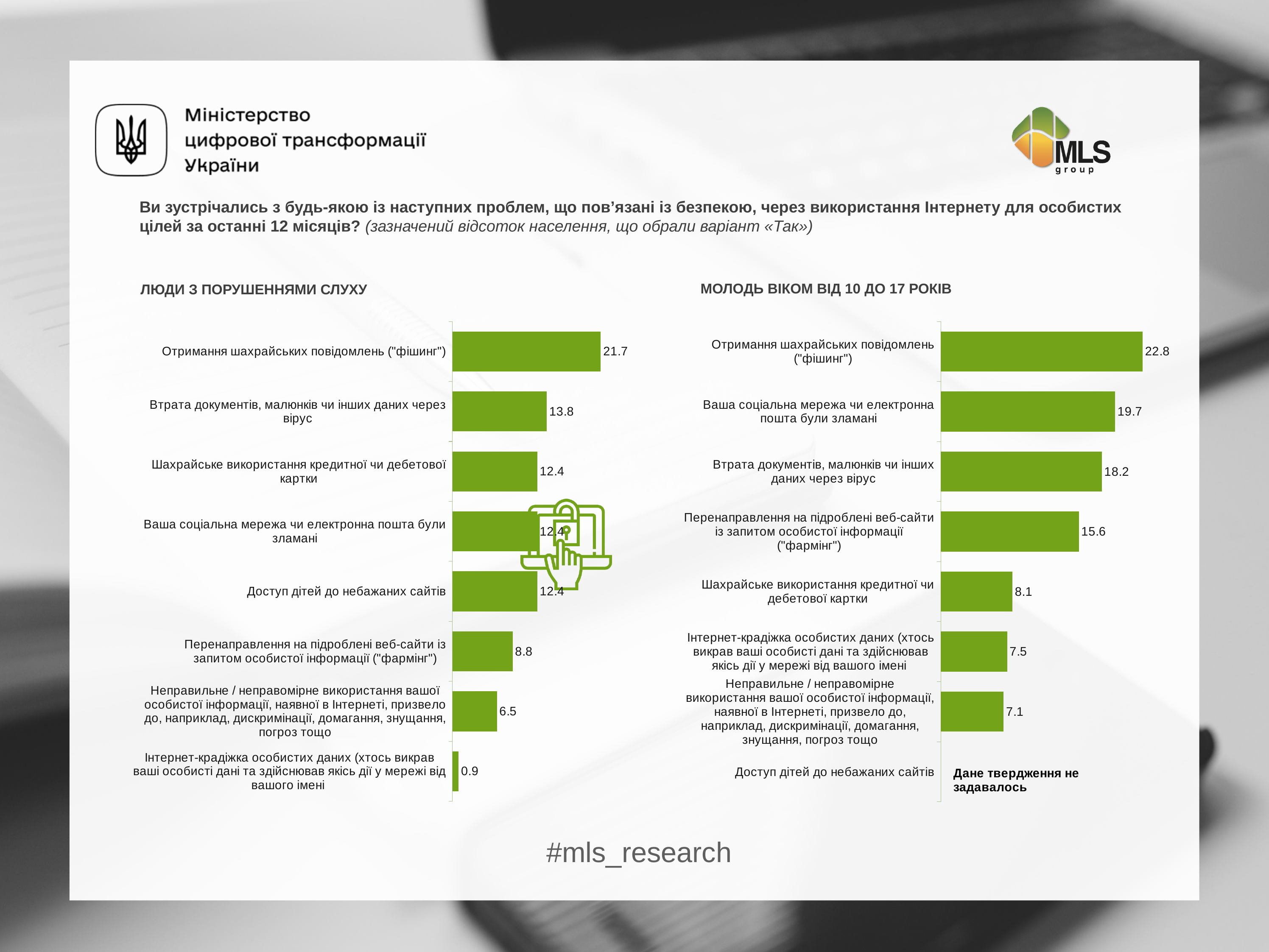
In the chart titled "ЛЮДИ З ПОРУШЕННЯМИ СЛУХУ", what is the value for "Неправильне / неправомірне використання вашої особистої інформації, наявної в Інтернеті, призвело до, наприклад, дискримінації, домагання, знущання, погроз тощо"? 6.5 How many bars are plotted in the chart titled "ЛЮДИ З ПОРУШЕННЯМИ СЛУХУ"? 8 In the chart titled "МОЛОДЬ ВІКОМ ВІД 10 ДО 17 РОКІВ", what is shown instead of a value for "Доступ дітей до небажаних сайтів"? Дане твердження не задавалось In the chart titled "МОЛОДЬ ВІКОМ ВІД 10 ДО 17 РОКІВ", what is the value for "Перенаправлення на підроблені веб-сайти із запитом особистої інформації ("фармінг")"? 15.6 Which is larger: the value for "Шахрайське використання кредитної чи дебетової картки" in the chart "ЛЮДИ З ПОРУШЕННЯМИ СЛУХУ" or in the chart "МОЛОДЬ ВІКОМ ВІД 10 ДО 17 РОКІВ"? ЛЮДИ З ПОРУШЕННЯМИ СЛУХУ What type of chart is used for "МОЛОДЬ ВІКОМ ВІД 10 ДО 17 РОКІВ"? Bar chart In the chart titled "ЛЮДИ З ПОРУШЕННЯМИ СЛУХУ", which category has the lowest value? Інтернет-крадіжка особистих даних (хтось викрав ваші особисті дані та здійснював якісь дії у мережі від вашого імені) In the chart titled "МОЛОДЬ ВІКОМ ВІД 10 ДО 17 РОКІВ", which category has the highest value? Отримання шахрайських повідомлень ("фішинг") In the chart titled "МОЛОДЬ ВІКОМ ВІД 10 ДО 17 РОКІВ", what is the difference between the values for "Отримання шахрайських повідомлень ("фішинг")" and "Втрата документів, малюнків чи інших даних через вірус"? 4.6 In the chart titled "ЛЮДИ З ПОРУШЕННЯМИ СЛУХУ", what is the difference between the values for "Втрата документів, малюнків чи інших даних через вірус" and "Перенаправлення на підроблені веб-сайти із запитом особистої інформації ("фармінг")"? 5.0 In the chart titled "МОЛОДЬ ВІКОМ ВІД 10 ДО 17 РОКІВ", what is the value for "Ваша соціальна мережа чи електронна пошта були зламані"? 19.7 In the chart titled "ЛЮДИ З ПОРУШЕННЯМИ СЛУХУ", what is the value for "Отримання шахрайських повідомлень ("фішинг")"? 21.7